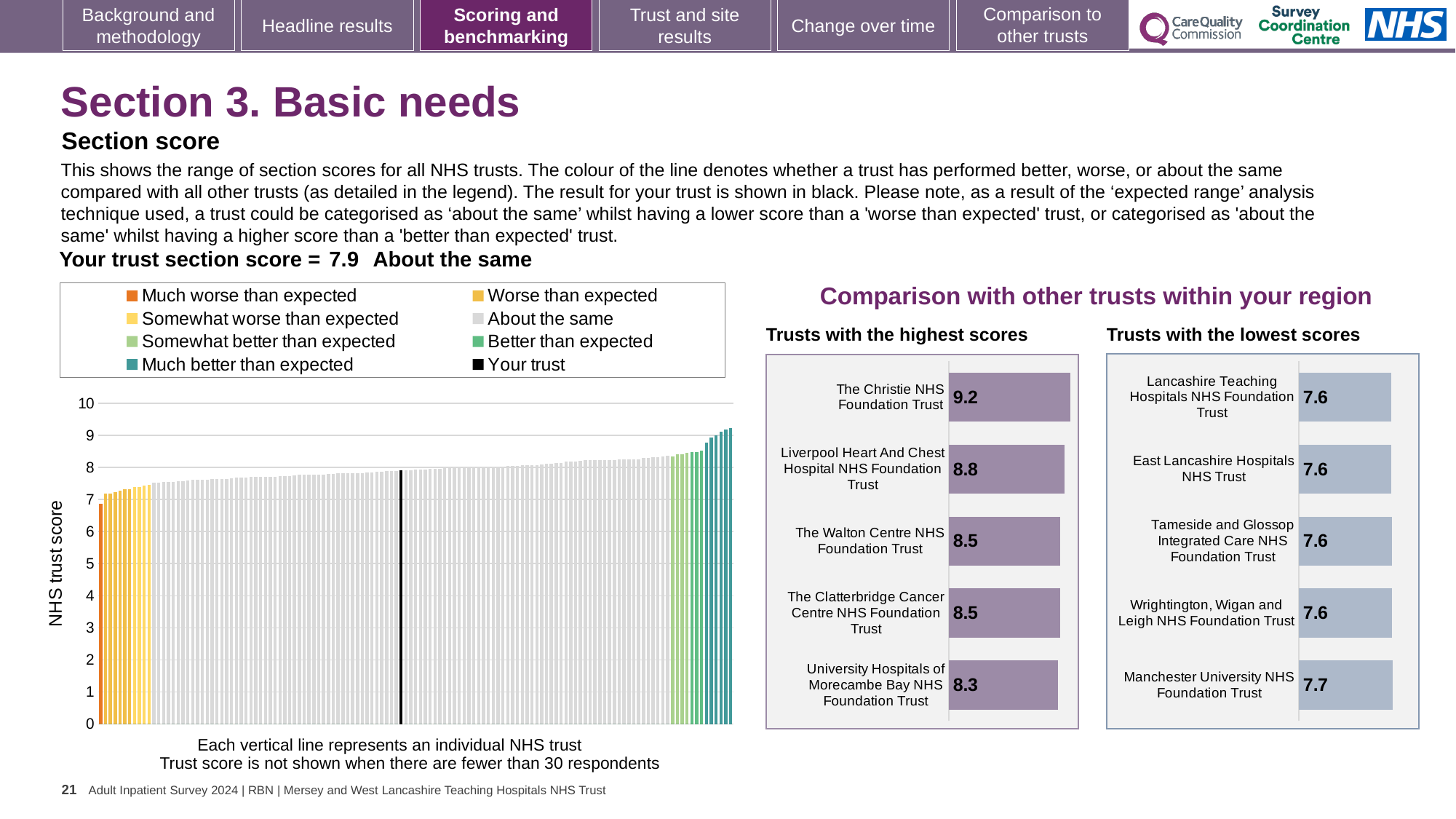
How many trusts are shown in the 'Trusts with the lowest scores' chart? 5 What kind of chart is the 'NHS trust score' chart on the left of the slide? Bar chart In the 'Trusts with the highest scores' chart, which trust has the lowest score? University Hospitals of Morecambe Bay NHS Foundation Trust In the 'Trusts with the lowest scores' chart, what is the score for Manchester University NHS Foundation Trust? 7.7 In the 'Trusts with the highest scores' chart, which trust has the highest score? The Christie NHS Foundation Trust In the 'Trusts with the lowest scores' chart, which trust has the highest score? Manchester University NHS Foundation Trust How many entries does the legend of the NHS trust score chart on the left list? 8 In the NHS trust score chart on the left, is the value for 'Your trust' (the black bar) greater or less than 7? greater In the 'Trusts with the highest scores' chart, what is the difference between the scores of The Christie NHS Foundation Trust and Liverpool Heart And Chest Hospital NHS Foundation Trust? 0.4 In the 'Trusts with the highest scores' chart, what is the score for University Hospitals of Morecambe Bay NHS Foundation Trust? 8.3 In the 'Trusts with the highest scores' chart, which has a higher score: Liverpool Heart And Chest Hospital NHS Foundation Trust or The Walton Centre NHS Foundation Trust? Liverpool Heart And Chest Hospital NHS Foundation Trust In the 'Trusts with the highest scores' chart, what is the score for The Christie NHS Foundation Trust? 9.2